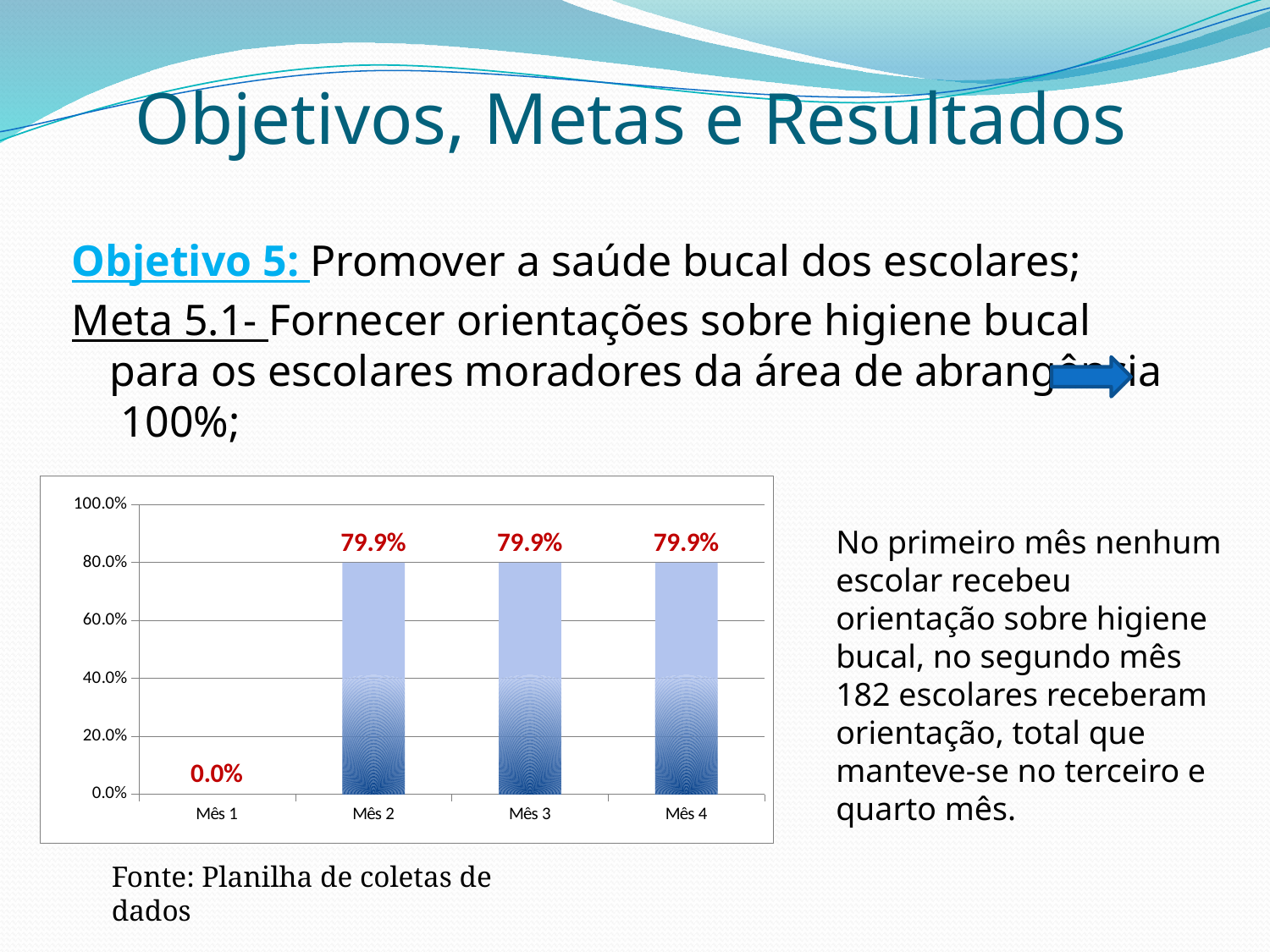
How many months are shown on the x axis? 4 What is the difference between the values for Mês 3 and Mês 1? 79.9% What is the value for Mês 1? 0.0% Which is larger, the value for Mês 1 or the value for Mês 2? Mês 2 What kind of chart is shown on the slide? bar chart Which month has the lowest value? Mês 1 What is the value for Mês 4? 79.9% Is the value for Mês 4 greater or less than 100.0%? less What is the highest tick value shown on the y axis? 100.0% Do the values rise or fall from Mês 1 to Mês 2? rise Is the value for Mês 3 greater or less than 60.0%? greater What is the value for Mês 2? 79.9%